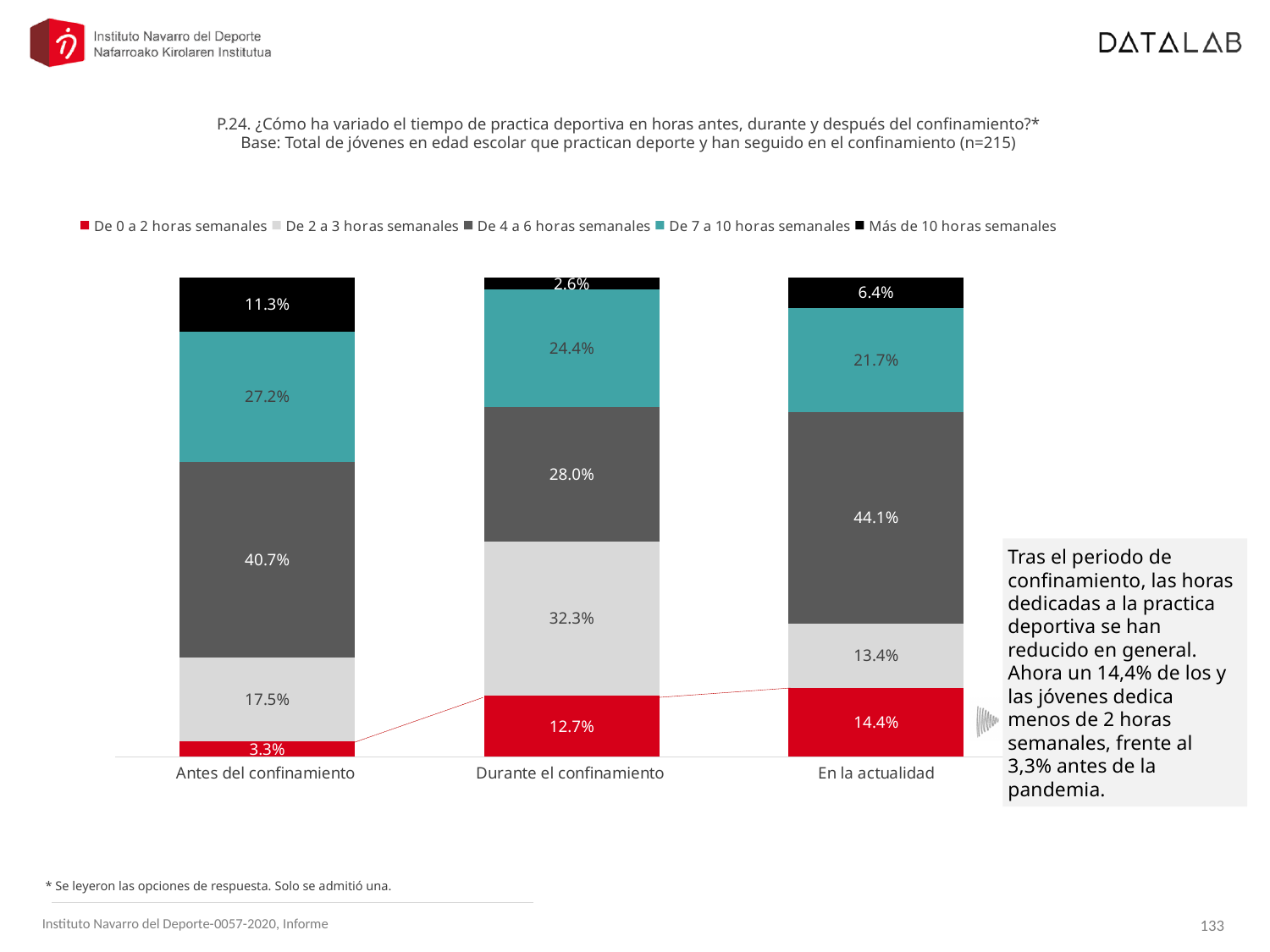
Which category has the highest value for 'De 0 a 2 horas semanales'? En la actualidad What type of chart is shown on the slide? Stacked bar chart What is the value for 'De 0 a 2 horas semanales' in 'Antes del confinamiento'? 3.3% Which category has the lowest value for 'Más de 10 horas semanales'? Durante el confinamiento What is the difference between the 'De 0 a 2 horas semanales' values for 'En la actualidad' and 'Antes del confinamiento'? 11.1% Which is larger: 'De 7 a 10 horas semanales' in 'Antes del confinamiento' or in 'En la actualidad'? Antes del confinamiento How many categories are shown on the x axis? 3 How many series does the legend list? 5 What is the value for 'De 2 a 3 horas semanales' in 'Durante el confinamiento'? 32.3% What is the value for 'De 4 a 6 horas semanales' in 'En la actualidad'? 44.1% What is the value for 'Más de 10 horas semanales' in 'Durante el confinamiento'? 2.6% Does the value for 'De 0 a 2 horas semanales' rise or fall from 'Antes del confinamiento' to 'En la actualidad'? Rise